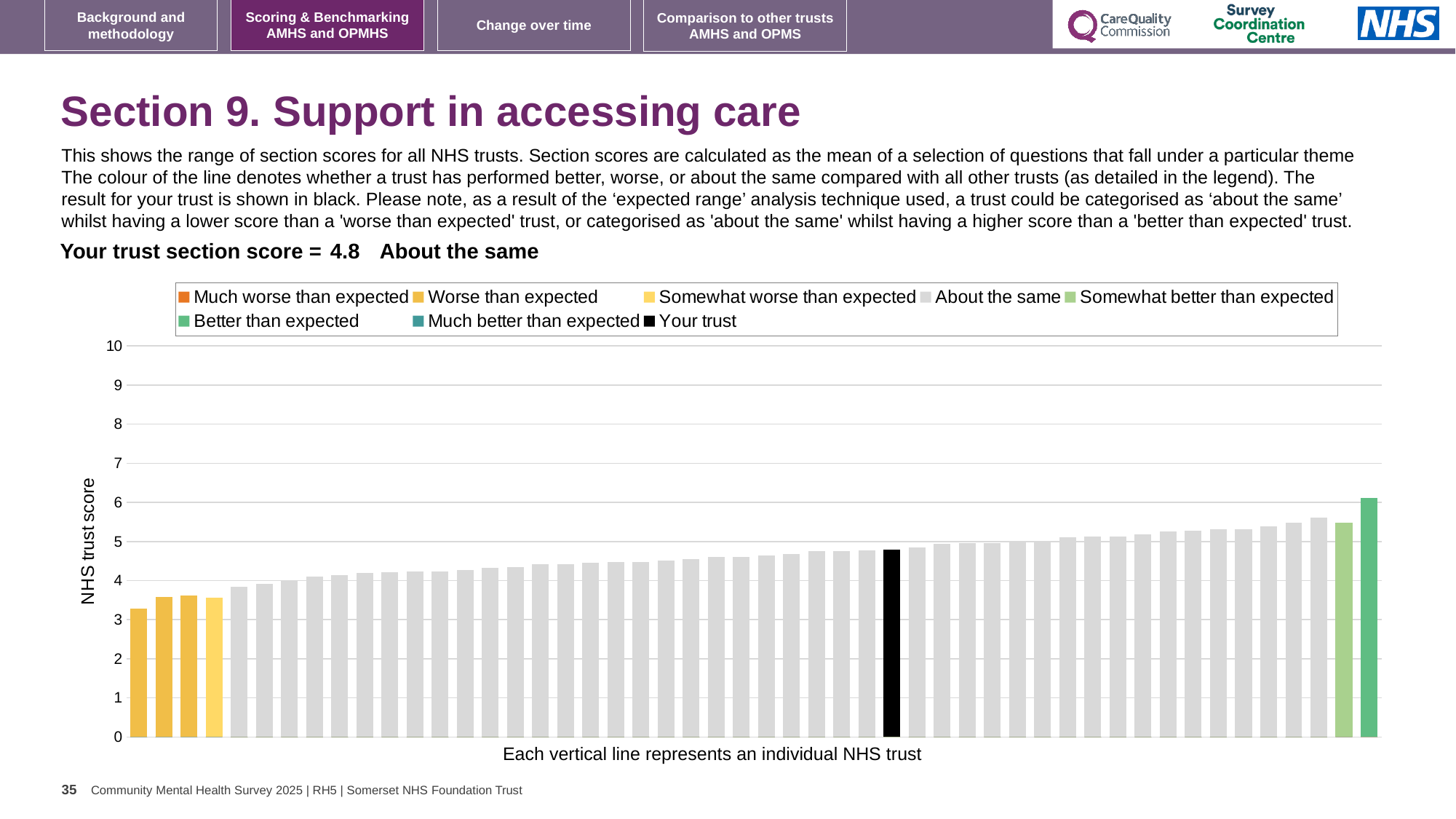
Which category is your trust placed in for this section? About the same Which legend category does the highest bar belong to? Better than expected How many entries does the legend list? 8 Is the value for the leftmost bar greater or less than 4? less Is the value for the tallest bar greater or less than 5? greater Do the bar values rise or fall from left to right along the x axis? rise What kind of chart is shown on the slide? bar chart What is the section score for your trust? 4.8 Which is larger, the leftmost bar or the rightmost bar? the rightmost bar What is the label on the y axis? NHS trust score What colour is the bar representing your trust? black Is the value for the black 'Your trust' bar greater or less than 4? greater